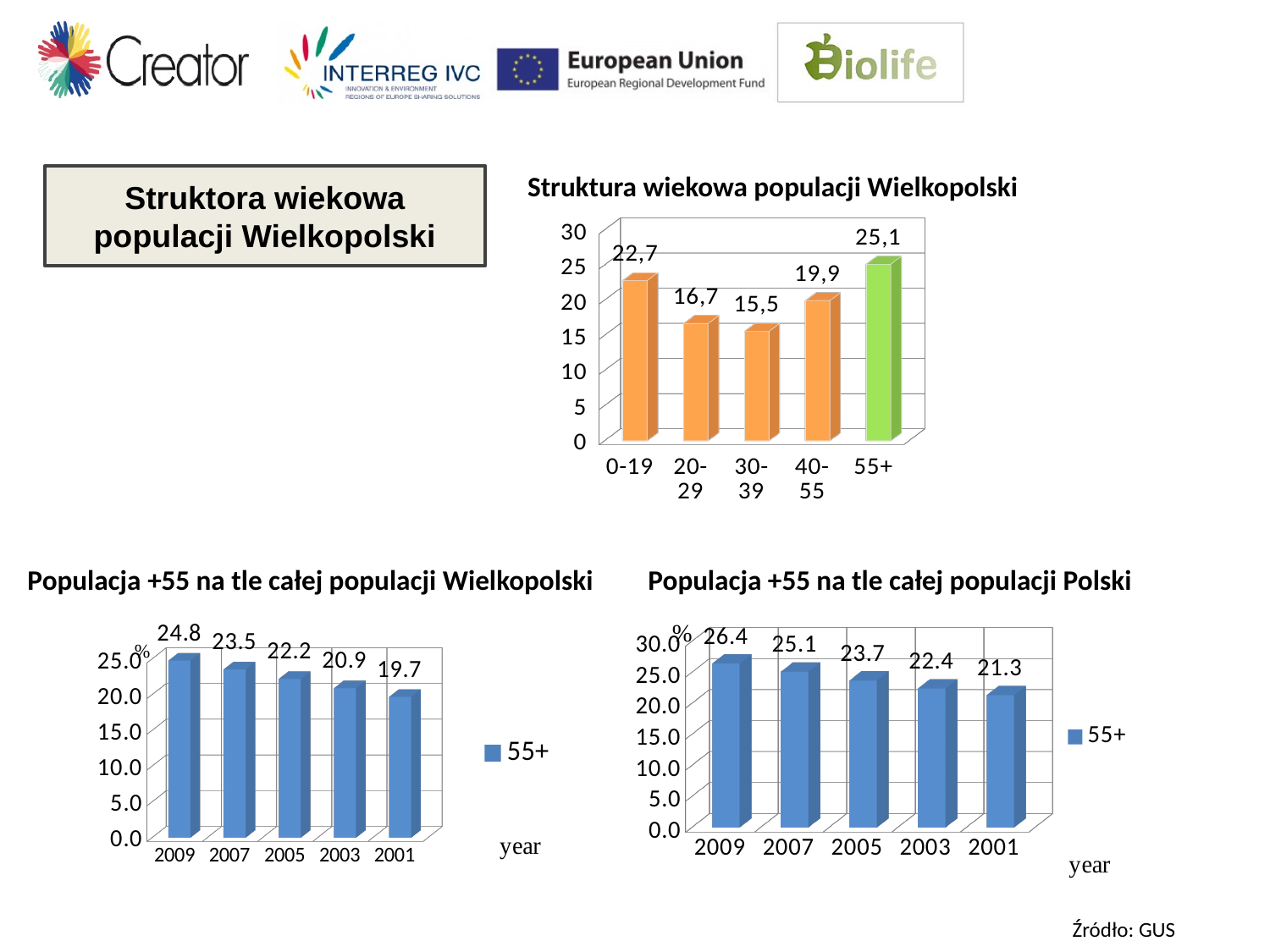
In the chart 'Populacja +55 na tle całej populacji Polski', do the values rise or fall from left to right along the x axis? fall In the chart 'Struktura wiekowa populacji Wielkopolski', which age group has the highest value? 55+ In the chart 'Populacja +55 na tle całej populacji Wielkopolski', what is the value for 2005? 22.2 In the chart 'Populacja +55 na tle całej populacji Polski', what is the value for 2003? 22.4 In the chart 'Struktura wiekowa populacji Wielkopolski', which age group has the lowest value? 30-39 In the chart 'Struktura wiekowa populacji Wielkopolski', how many age groups are shown? 5 In the chart 'Populacja +55 na tle całej populacji Wielkopolski', what is the difference between the 2009 value and the 2001 value? 5.1 In the chart 'Struktura wiekowa populacji Wielkopolski', what is the difference between the 55+ value and the 30-39 value? 9,6 In the chart 'Struktura wiekowa populacji Wielkopolski', what is the value for the 0-19 age group? 22,7 Which is larger: the 2009 value in 'Populacja +55 na tle całej populacji Polski' or the 2009 value in 'Populacja +55 na tle całej populacji Wielkopolski'? Polski (26.4) In the chart 'Struktura wiekowa populacji Wielkopolski', which bar is coloured green? 55+ In the chart 'Populacja +55 na tle całej populacji Wielkopolski', which year has the lowest value? 2001